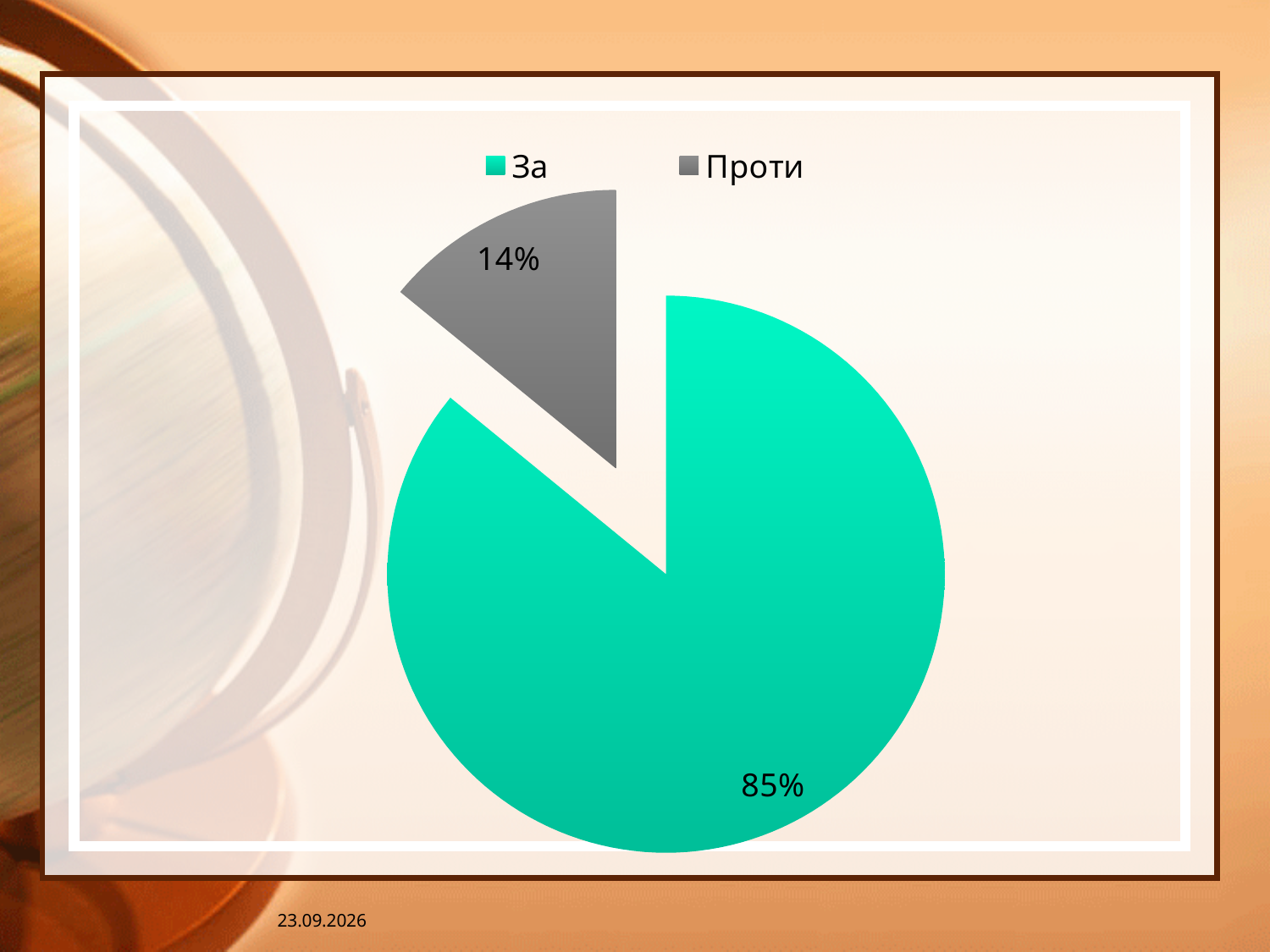
Which slice of the pie is the smallest? Проти What colour is the "За" slice? green Which slice of the pie is the largest? За How many entries does the legend list? 2 Which is larger, the "За" slice or the "Проти" slice? За How many slices does the pie chart have? 2 What share of the pie does the "За" slice represent? 85% What colour is the "Проти" slice? grey What is the difference in percentage points between the "За" and "Проти" slices? 71 What share of the pie does the "Проти" slice represent? 14% What kind of chart is shown on the slide? pie chart